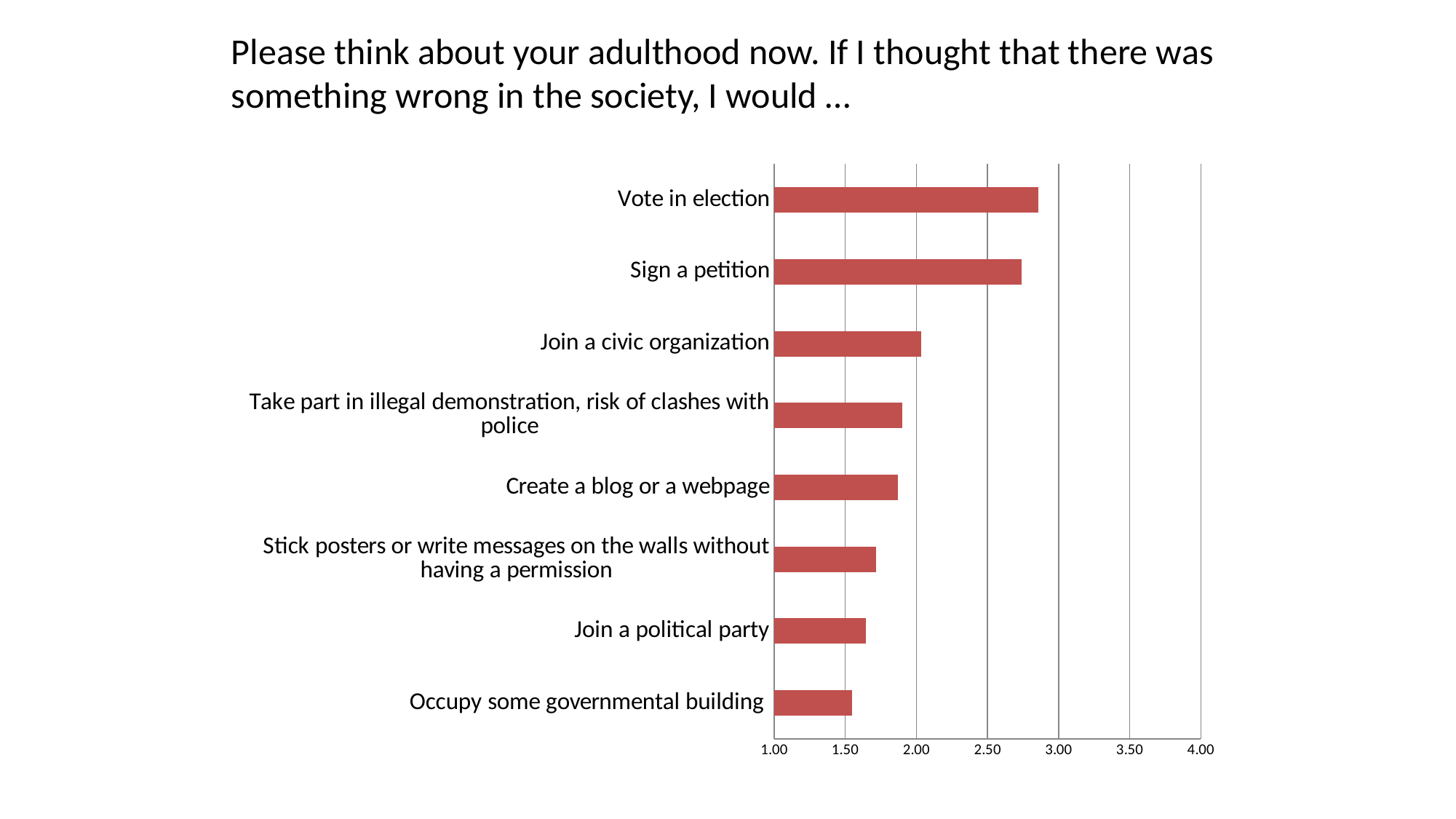
What kind of chart is shown on the slide? bar chart What is the maximum value shown on the horizontal axis of the chart? 4.00 Is the value for Sign a petition greater or less than 2.50? greater Which has a larger value: Sign a petition or Occupy some governmental building? Sign a petition Is the value for Join a civic organization greater or less than 2.50? less How many categories (actions) are plotted in the chart? 8 Is the value for Join a political party greater or less than 2.00? less Which action has the lowest value in the chart? Occupy some governmental building Which has a larger value: Vote in election or Join a civic organization? Vote in election Which action has the highest value in the chart? Vote in election